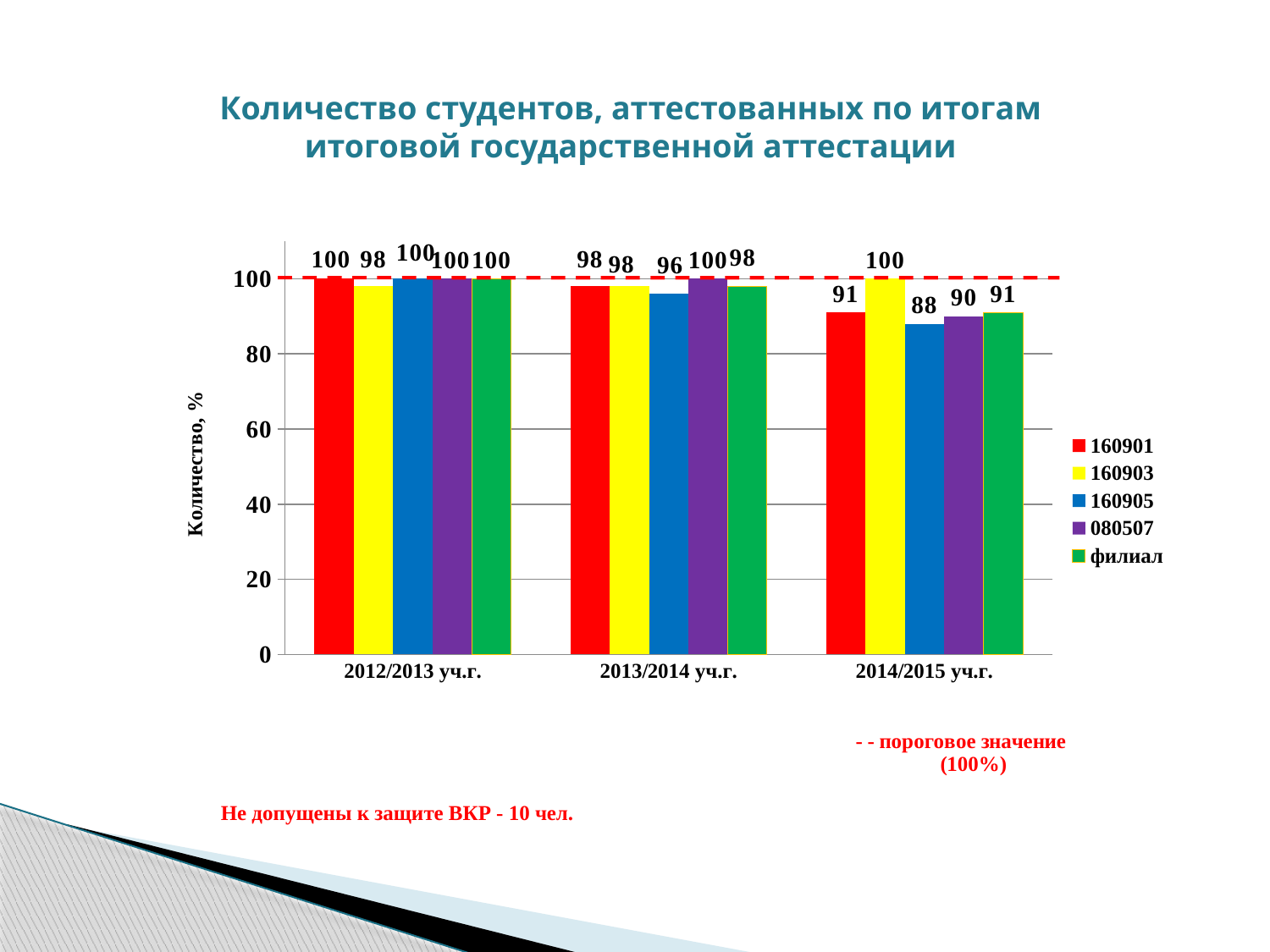
What is the difference between the 160903 value and the 160905 value in 2014/2015 уч.г.? 12 What is the value for 160905 in 2014/2015 уч.г.? 88 What is the value for 160905 in 2013/2014 уч.г.? 96 Which series has the highest value in 2013/2014 уч.г.? 080507 How many series does the legend list? 5 Which series has the lowest value in 2014/2015 уч.г.? 160905 What is the value for 080507 in 2014/2015 уч.г.? 90 What kind of chart is shown on the slide? bar chart What threshold value does the red dashed line mark? 100% Which is larger: the value for 160901 in 2013/2014 уч.г. or in 2014/2015 уч.г.? 2013/2014 уч.г. How many academic-year categories are shown on the x axis? 3 What is the value for 160903 in 2012/2013 уч.г.? 98